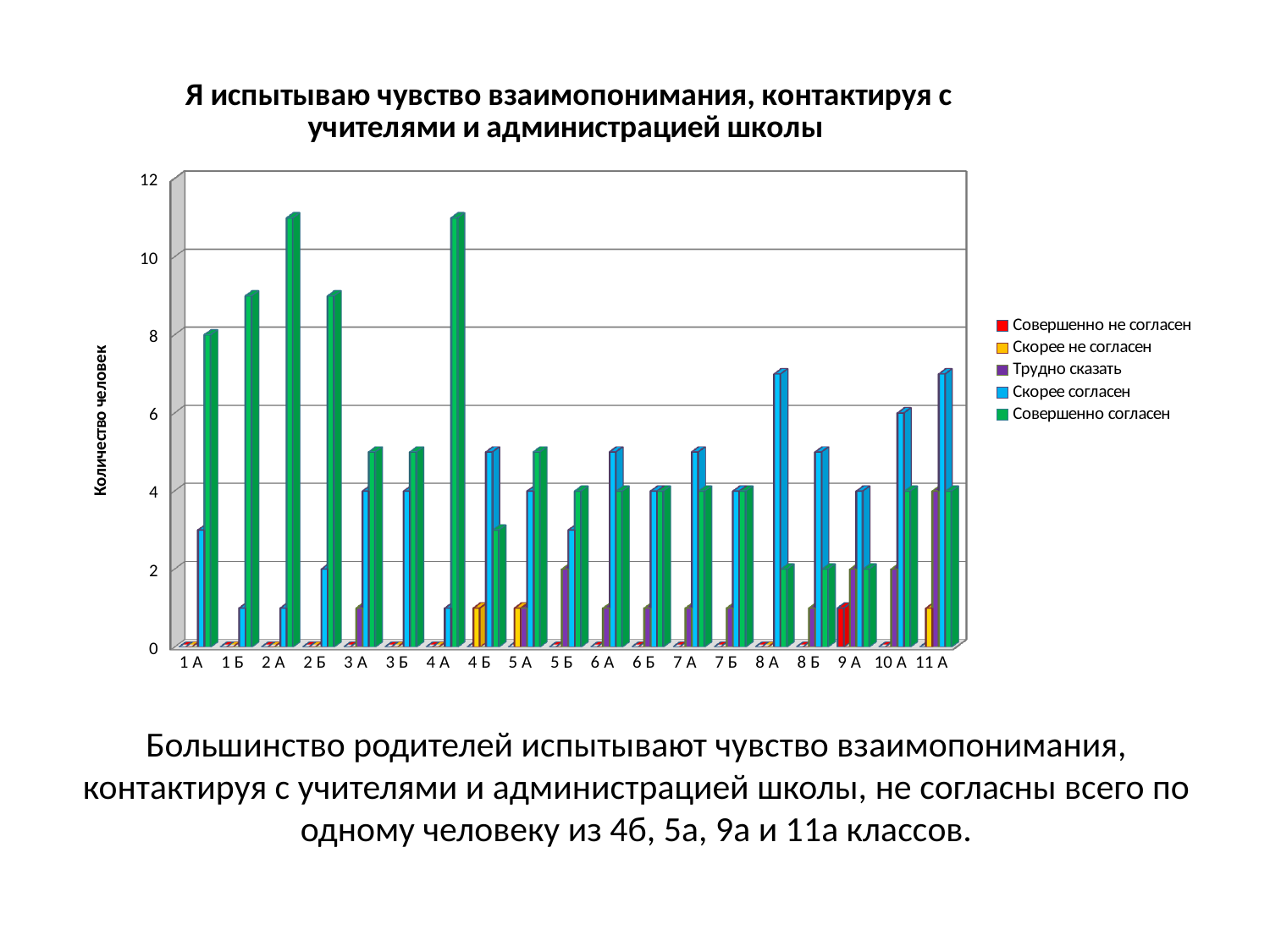
Is the value of "Скорее согласен" for class 8 А greater or less than 6? greater How many series does the legend list? 5 What kind of chart is shown on the slide? bar chart For class 8 А, which is larger: "Скорее согласен" or "Совершенно согласен"? Скорее согласен Which is larger: "Совершенно согласен" for class 1 А or for class 3 А? 1 А Is the value of "Совершенно согласен" for class 1 А greater or less than 6? greater Is the value of "Совершенно согласен" for class 4 Б greater or less than 4? less What is the title of the y axis? Количество человек How many classes (categories) are shown along the x axis? 19 Which legend entry is shown in red? Совершенно не согласен